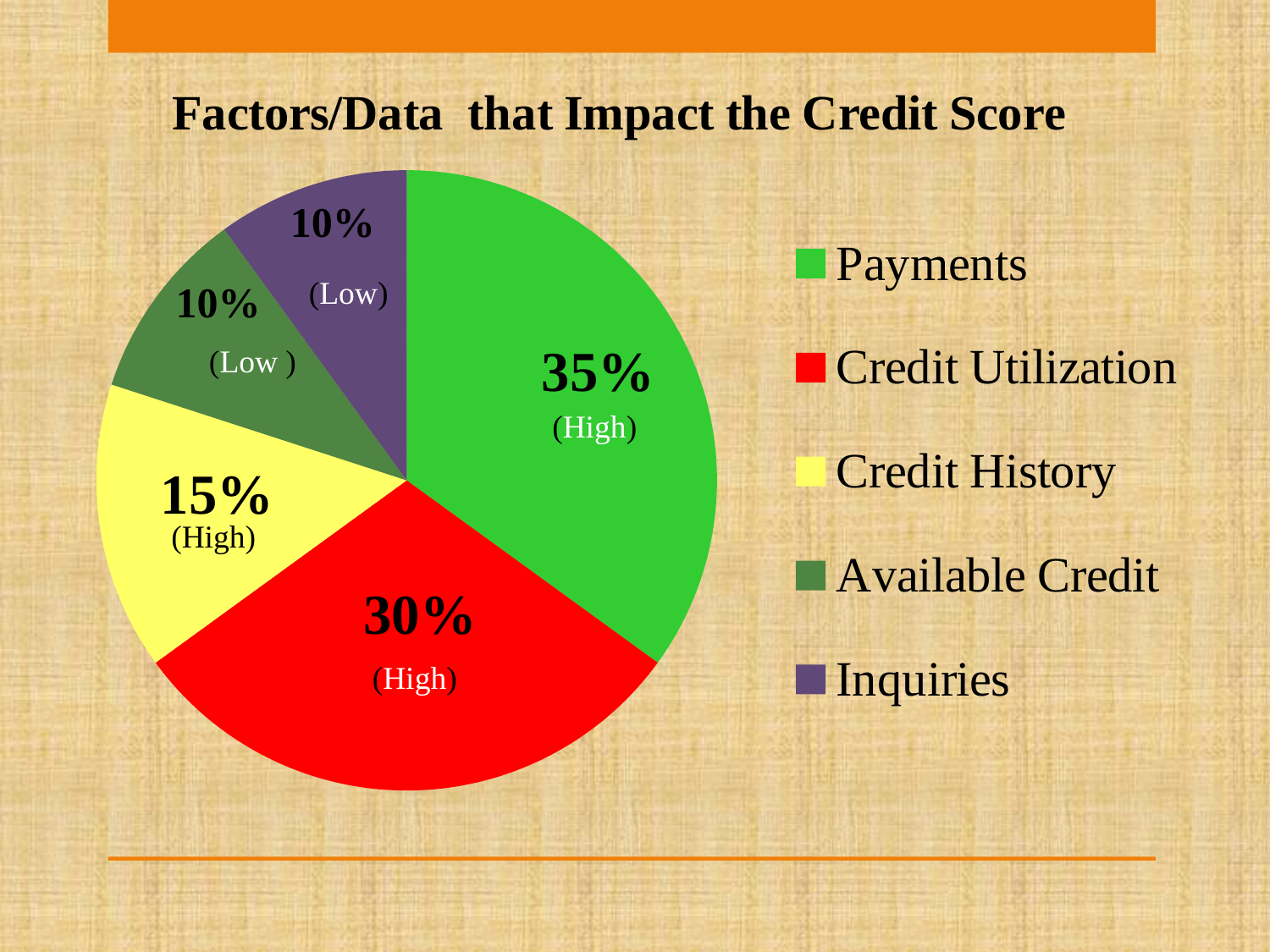
What percentage of the pie is Payments? 35% What percentage of the pie is Available Credit? 10% What percentage of the pie is Credit History? 15% What kind of chart is shown on the slide? pie chart How many slices does the pie chart have? 5 Which factor has the largest share of the pie? Payments What is the title of the chart? Factors/Data that Impact the Credit Score How many entries does the legend list? 5 What percentage of the pie is Credit Utilization? 30% What colour is the Inquiries slice? purple Which is larger, Credit History or Credit Utilization? Credit Utilization What is the difference in percentage points between Payments and Credit Utilization? 5